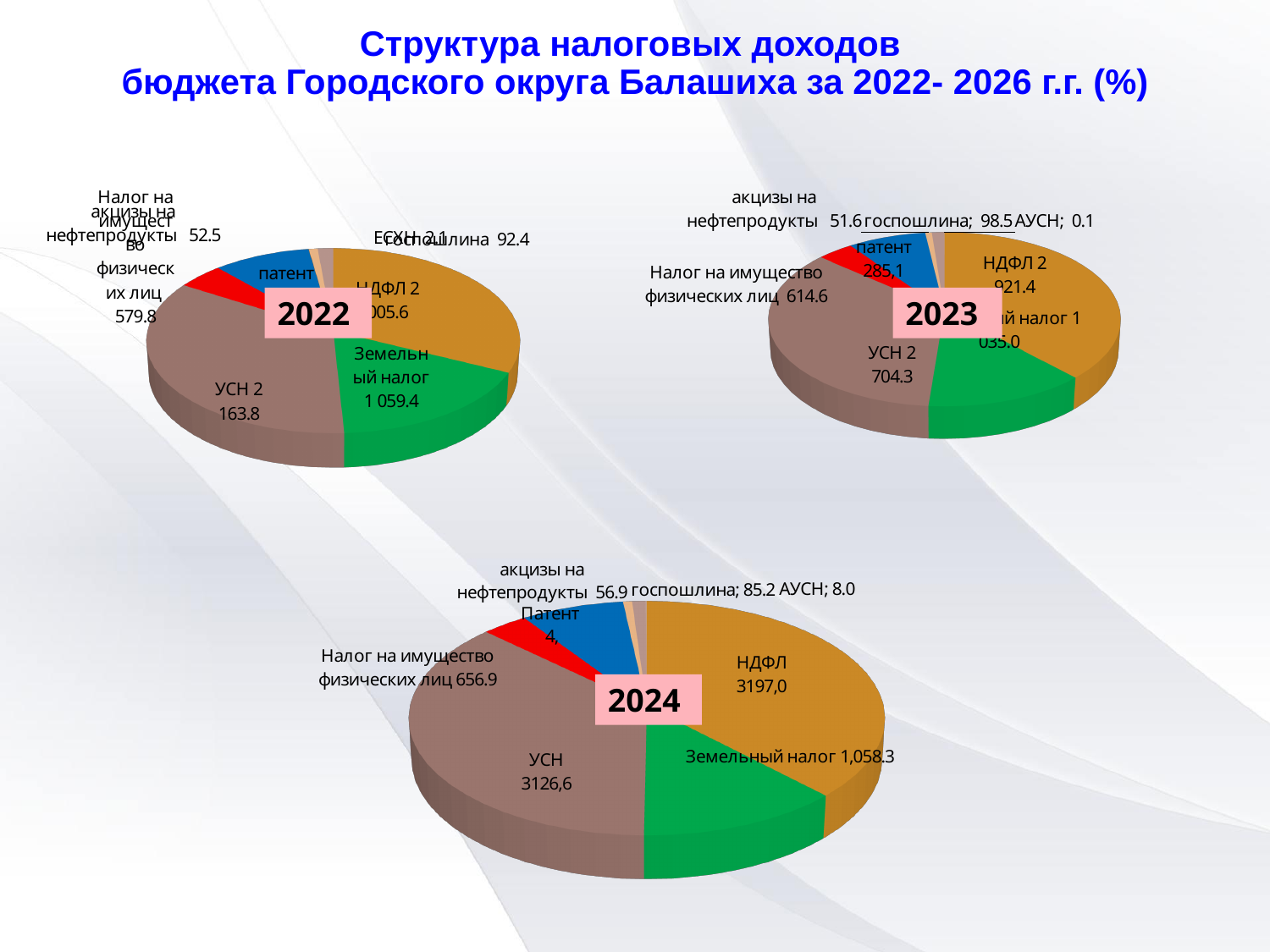
In the 2023 pie chart, what is the difference between НДФЛ (2 921.4) and УСН (2 704.3)? 217.1 In the 2023 pie chart, what is the value for АУСН? 0.1 What is the difference between the госпошлина value in the 2023 chart (98.5) and in the 2024 chart (85.2)? 13.3 How many pie charts are on the slide? 3 In the 2022 pie chart, what is the value for Земельный налог? 1 059.4 In the 2024 pie chart, which is larger: Земельный налог or Налог на имущество физических лиц? Земельный налог In the 2023 pie chart, what is the value for Налог на имущество физических лиц? 614.6 In the 2024 pie chart, what is the value for УСН? 3126,6 In the 2024 pie chart, what is the value for Земельный налог? 1,058.3 What colour is the НДФЛ slice in the 2024 pie chart? Gold (orange-brown) In the 2024 pie chart, what is the value for НДФЛ? 3197,0 What kind of charts are shown on the slide? Pie charts